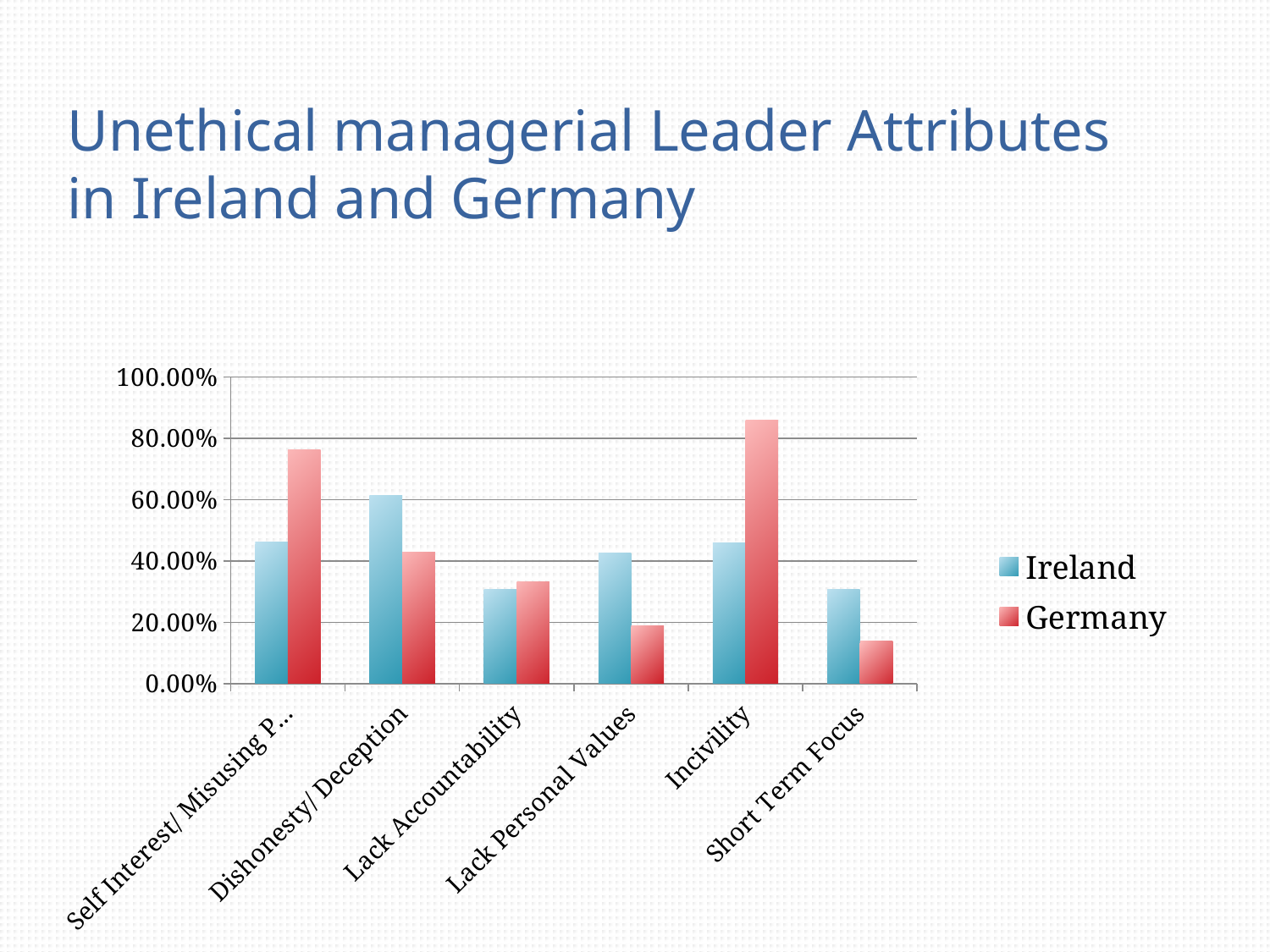
Which category has the lowest value for Germany? Short Term Focus How many categories are shown on the x axis? 6 What kind of chart is shown on the slide? bar chart How many series does the legend list? 2 Which colour represents Germany in the chart? red For Incivility, which is larger, the value for Ireland or the value for Germany? Germany Which category has the highest value for Ireland? Dishonesty/ Deception Is the value for Germany for Incivility greater or less than 80.00%? greater Which category has the highest value for Germany? Incivility For Short Term Focus, which is larger, the value for Ireland or the value for Germany? Ireland